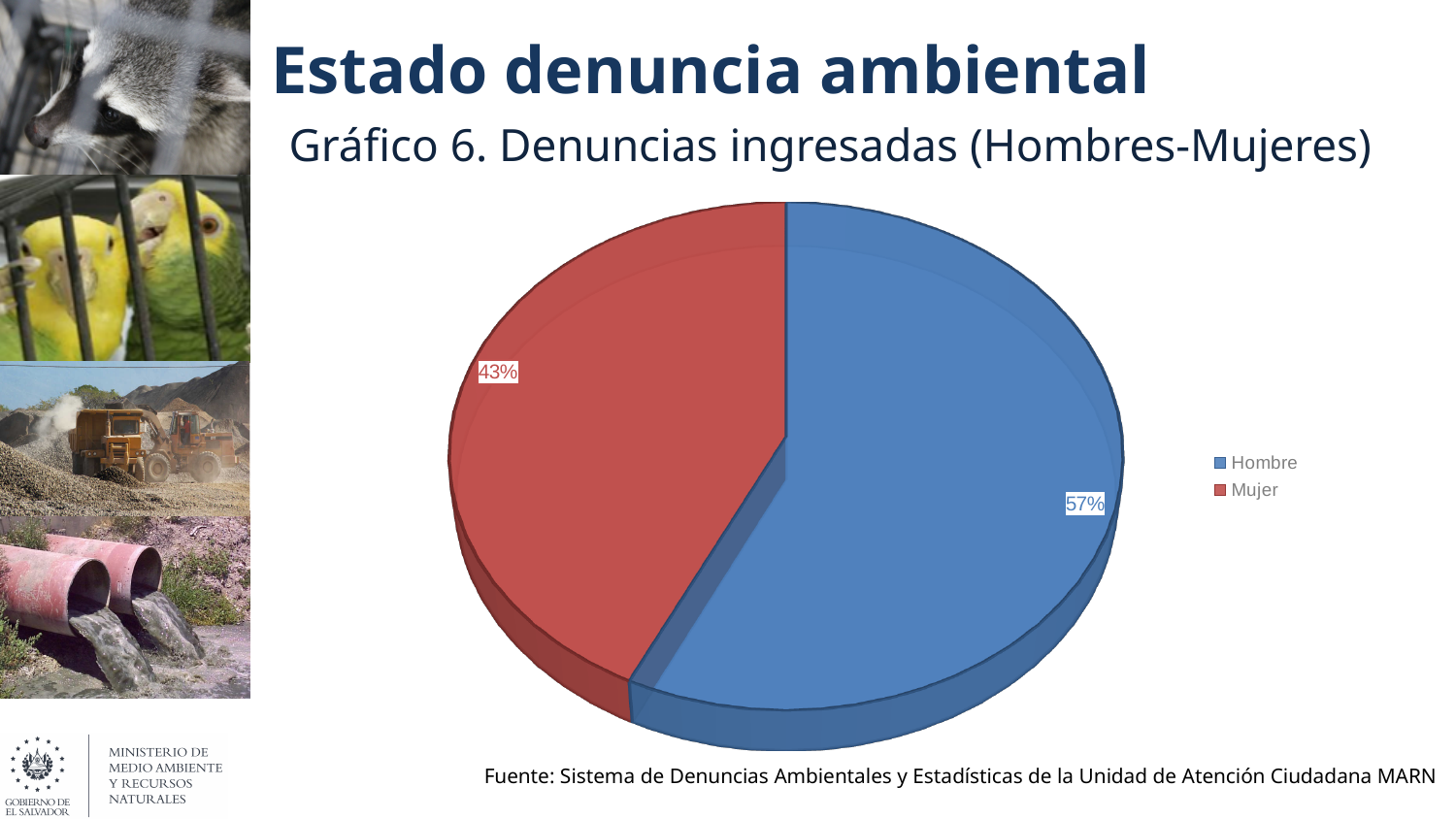
Which category has the smallest slice of the pie? Mujer Which category has the largest slice of the pie? Hombre What share of the pie does Mujer represent? 43% How many categories does the pie chart show? 2 What colour is the Mujer slice? red How many entries does the legend list? 2 What is the difference in percentage points between the Hombre and Mujer slices? 14 percentage points What kind of chart is shown on the slide? pie chart What share of the pie does Hombre represent? 57% Which slice is larger, Hombre or Mujer? Hombre What is the title of the chart? Gráfico 6. Denuncias ingresadas (Hombres-Mujeres)